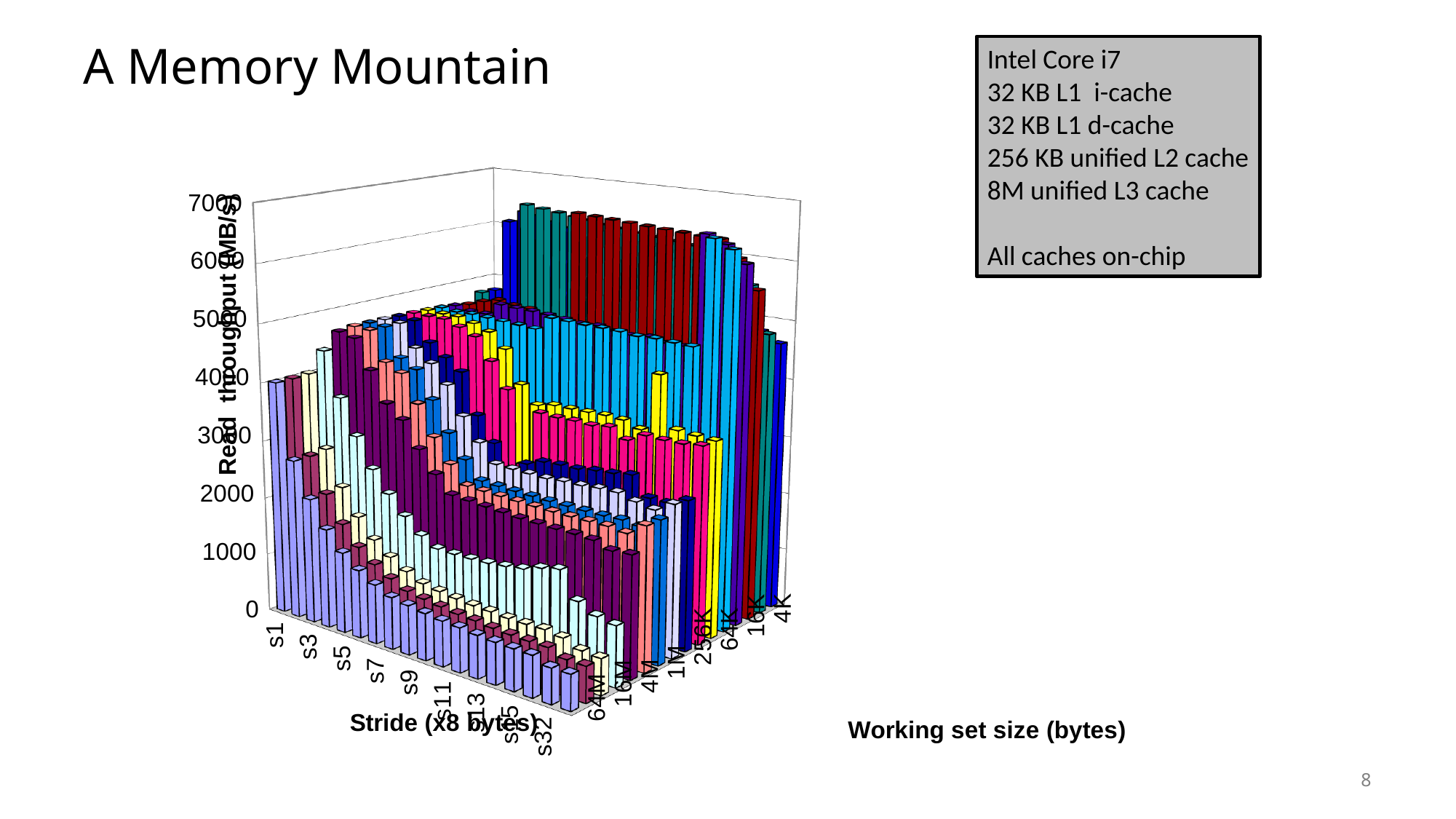
What is the label of the vertical axis of the chart? Read throughput (MB/s) Is the highest read throughput for the 16K working set greater or less than 6000 MB/s? greater At stride s1, does read throughput rise or fall as the working set size increases from 4K to 64M? fall How many working set size labels are printed along the working set size axis of the chart? 8 Is the read throughput for the 64M working set at stride s32 greater or less than 1000 MB/s? less Which is larger: the read throughput at stride s1 for the 64M working set, or at stride s32 for the 64M working set? stride s1 How many stride labels are printed along the stride axis of the chart? 9 What is the highest tick value shown on the vertical axis of the chart? 7000 What is the title of the chart on the slide? A Memory Mountain What kind of chart is shown on the slide? bar chart For the 64M working set, does read throughput rise or fall as the stride increases from s1 to s32? fall